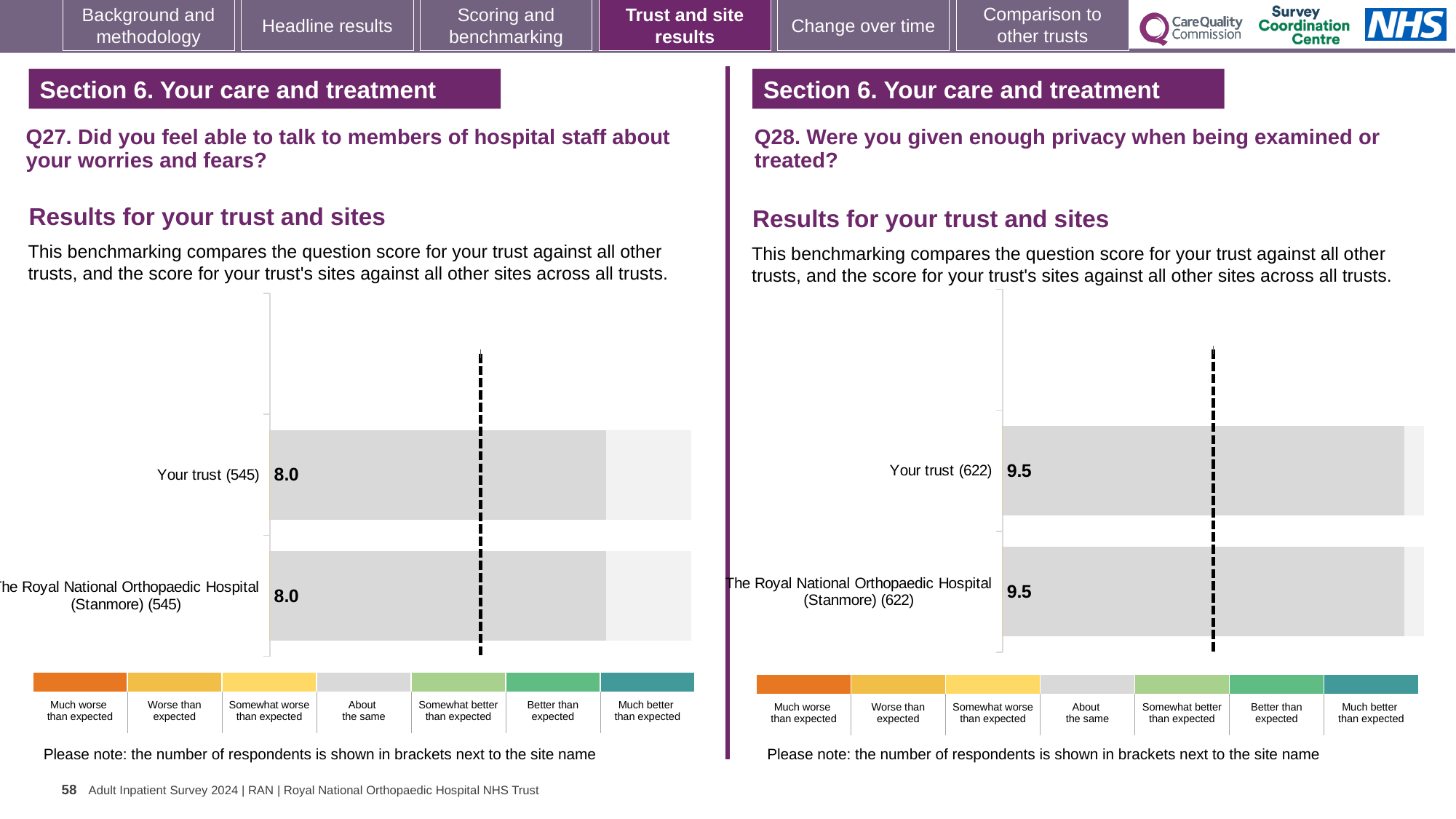
On the Q27 chart (left), what is the score for The Royal National Orthopaedic Hospital (Stanmore)? 8.0 On the Q27 chart (left), what is the score for Your trust? 8.0 On the Q28 chart (right), how many respondents are shown in brackets next to The Royal National Orthopaedic Hospital (Stanmore)? 622 On the Q28 chart (right), what is the score for The Royal National Orthopaedic Hospital (Stanmore)? 9.5 What kind of chart is used for the Q27 results on the left? Bar chart On the Q28 chart (right), what is the score for Your trust? 9.5 On the Q27 chart (left), what is the difference between the score for Your trust and the score for The Royal National Orthopaedic Hospital (Stanmore)? 0.0 How many bars are plotted on the Q28 chart (right)? 2 On the Q28 chart (right), what is the difference between the score for Your trust and the score for The Royal National Orthopaedic Hospital (Stanmore)? 0.0 How many bars are plotted on the Q27 chart (left)? 2 How many categories does the colour key below the Q28 chart (right) list? 7 On the Q27 chart (left), how many respondents are shown in brackets next to Your trust? 545